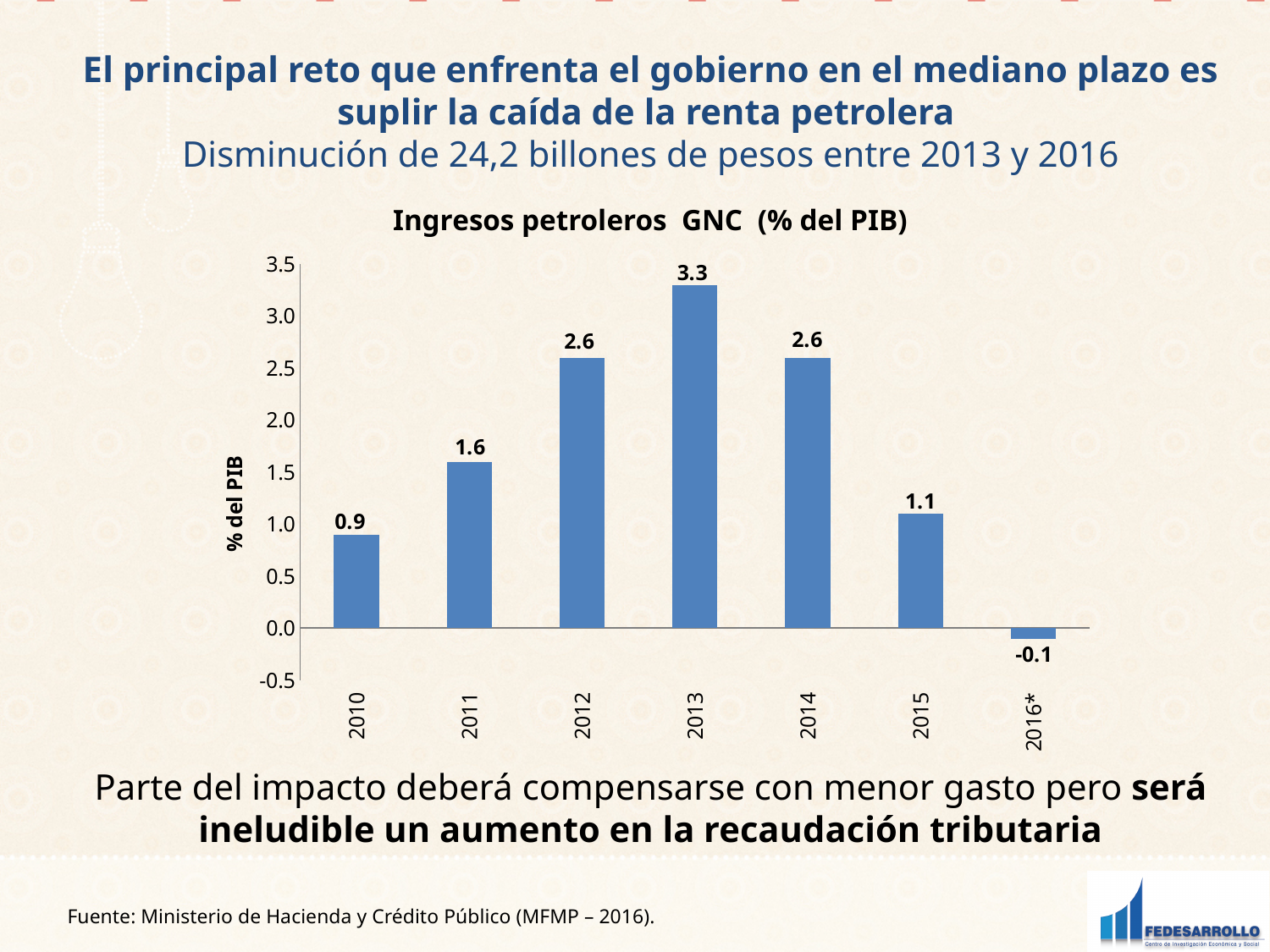
Which is larger, the value for 2011 or the value for 2015? 2011 What is the value for 2013 in the chart? 3.3 What is the title of the chart? Ingresos petroleros GNC (% del PIB) What kind of chart is shown on the slide? bar chart What is the value for 2010 in the chart? 0.9 What is the difference between the values for 2013 and 2015? 2.2 What is the value for 2016* in the chart? -0.1 Which year has the lowest value in the chart? 2016* Is the value for 2014 greater or less than 2.0? greater Which year has the highest value in the chart? 2013 How many years are shown on the x axis of the chart? 7 Do the values rise or fall from 2013 to 2016*? fall